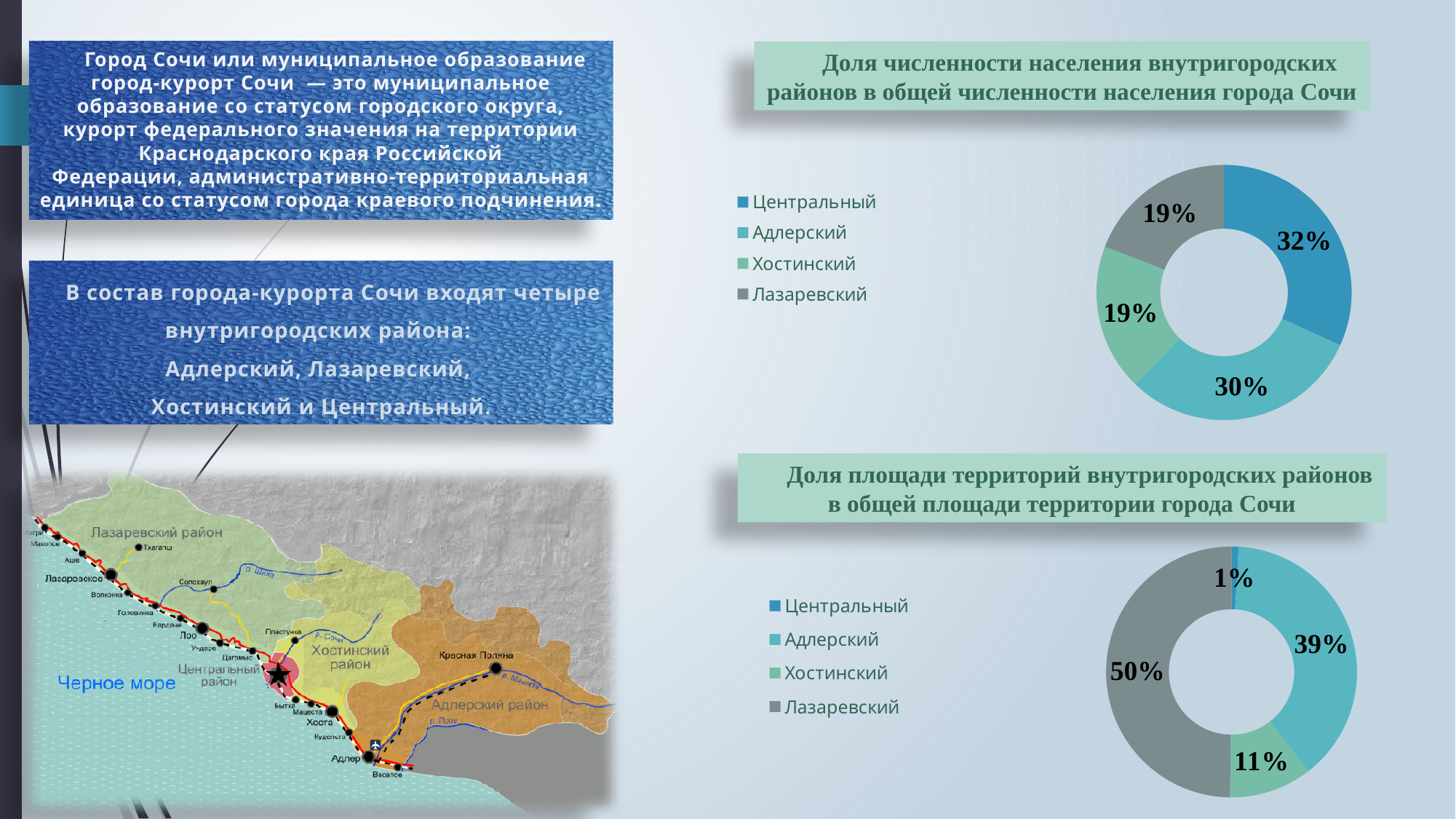
In the bottom chart (area share), which district has the largest share? Лазаревский In the bottom chart (area share), what is the difference between the shares of Лазаревский and Адлерский? 11 percentage points In the bottom chart (area share), which district has the smallest share? Центральный In the bottom chart (Доля площади территорий внутригородских районов), what share does Лазаревский have? 50% In the bottom chart (area share), what share does Центральный have? 1% In the top chart (population share), which district has the largest share? Центральный In the top chart (population share), what is the difference between the shares of Центральный and Хостинский? 13 percentage points In the top chart (Доля численности населения внутригородских районов), what share does Центральный have? 32% In the top chart (population share), what share does Адлерский have? 30% In the bottom chart (area share), which is larger: the share of Адлерский or the share of Хостинский? Адлерский In the top chart (population share), how many districts are shown? 4 What type of chart is used for the bottom chart (area share)? Doughnut (pie) chart